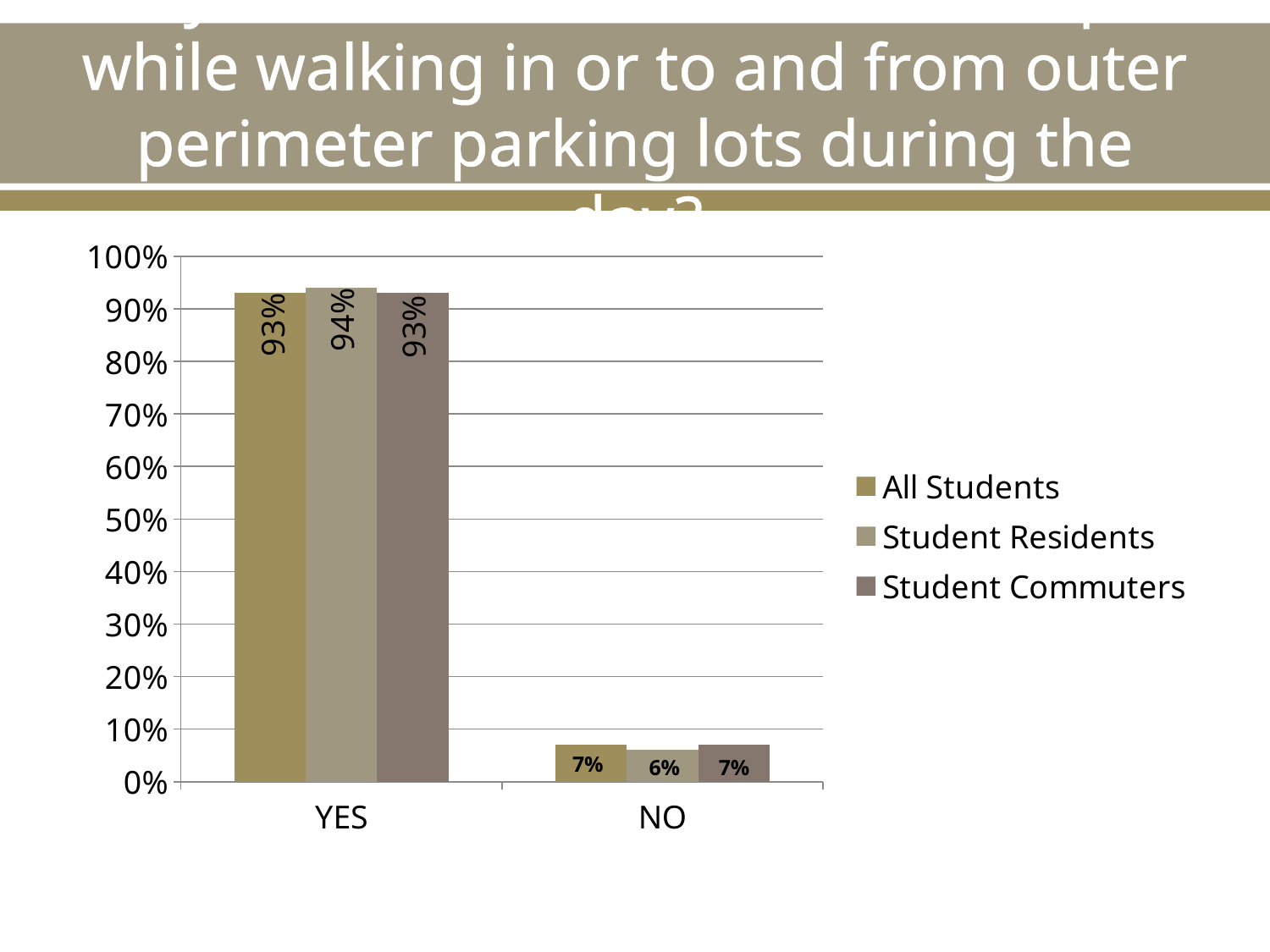
What kind of chart is shown on the slide? bar chart Is the value for Student Residents in the NO category greater or less than 10%? less What is the difference between the YES and NO values for All Students? 86% What is the value for All Students in the YES category? 93% What is the value for Student Residents in the YES category? 94% How many categories are shown on the x axis? 2 What is the difference between the Student Residents values for YES and NO? 88% Which category has the higher value for Student Commuters, YES or NO? YES How many series does the legend list? 3 Is the value for All Students in the YES category greater or less than 90%? greater What is the value for Student Residents in the NO category? 6% What is the value for Student Commuters in the NO category? 7%